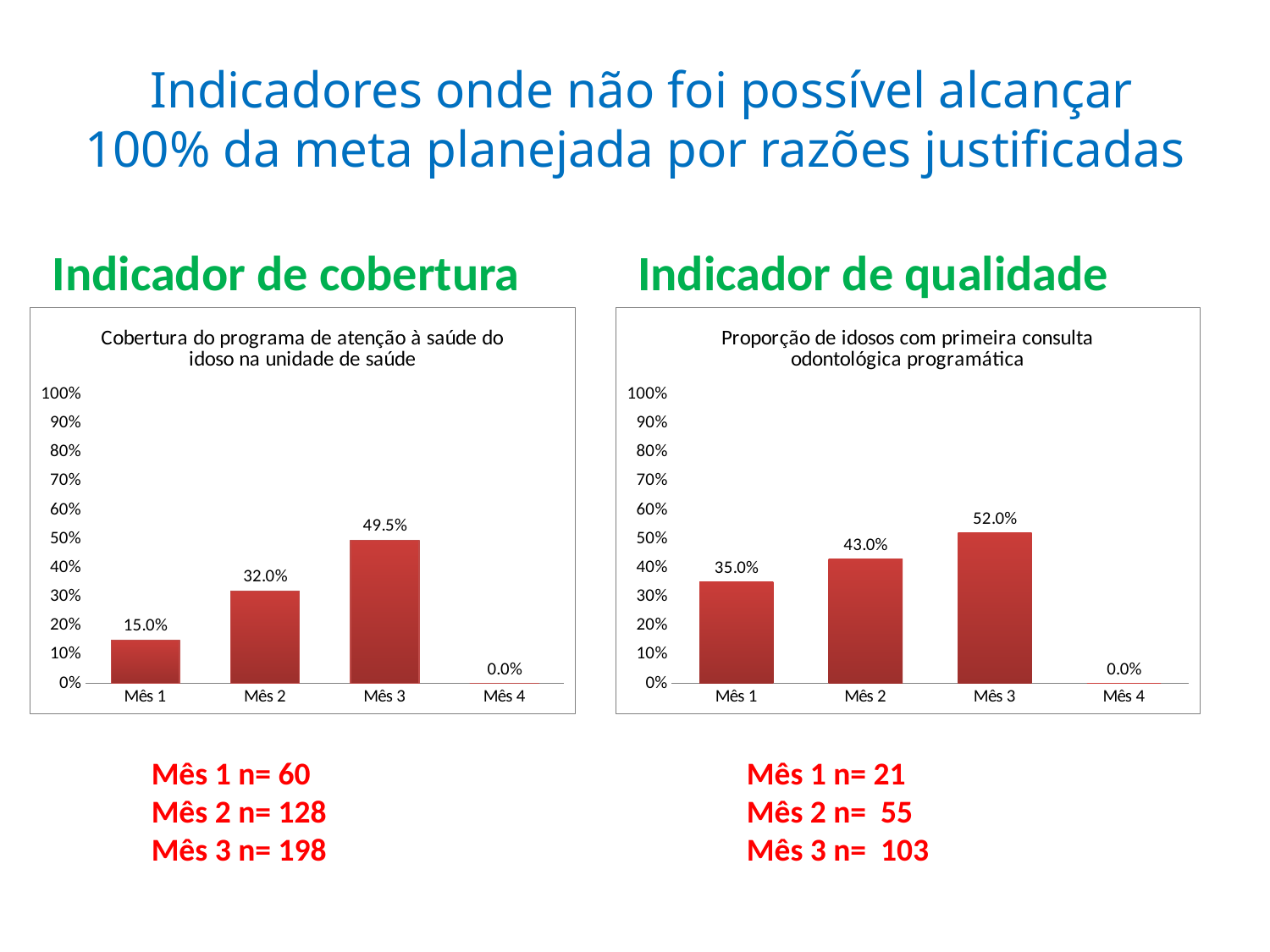
In the right chart (Proporção de idosos com primeira consulta odontológica programática), what is the difference between the values for Mês 3 and Mês 2? 9.0% In the left chart (Cobertura do programa de atenção à saúde do idoso na unidade de saúde), what is the value for Mês 2? 32.0% How many months (categories) are shown on the x axis of the right chart (Proporção de idosos com primeira consulta odontológica programática)? 4 What kind of chart is the left chart (Cobertura do programa de atenção à saúde do idoso)? Bar chart In the right chart (Proporção de idosos com primeira consulta odontológica programática), do the values rise or fall from Mês 1 to Mês 3? Rise In the right chart (Proporção de idosos com primeira consulta odontológica programática), which month has the lowest value? Mês 4 Which is larger: the value for Mês 3 in the left chart (Cobertura) or the value for Mês 3 in the right chart (Proporção de idosos)? Mês 3 in the right chart (52.0%) In the right chart (Proporção de idosos com primeira consulta odontológica programática), what is the value for Mês 1? 35.0% In the left chart (Cobertura do programa de atenção à saúde do idoso), what is the difference between the values for Mês 3 and Mês 1? 34.5% What is the title of the right chart? Proporção de idosos com primeira consulta odontológica programática In the left chart (Cobertura do programa de atenção à saúde do idoso), which month has the highest value? Mês 3 In the left chart (Cobertura do programa de atenção à saúde do idoso), is the value for Mês 3 greater or less than 40%? greater